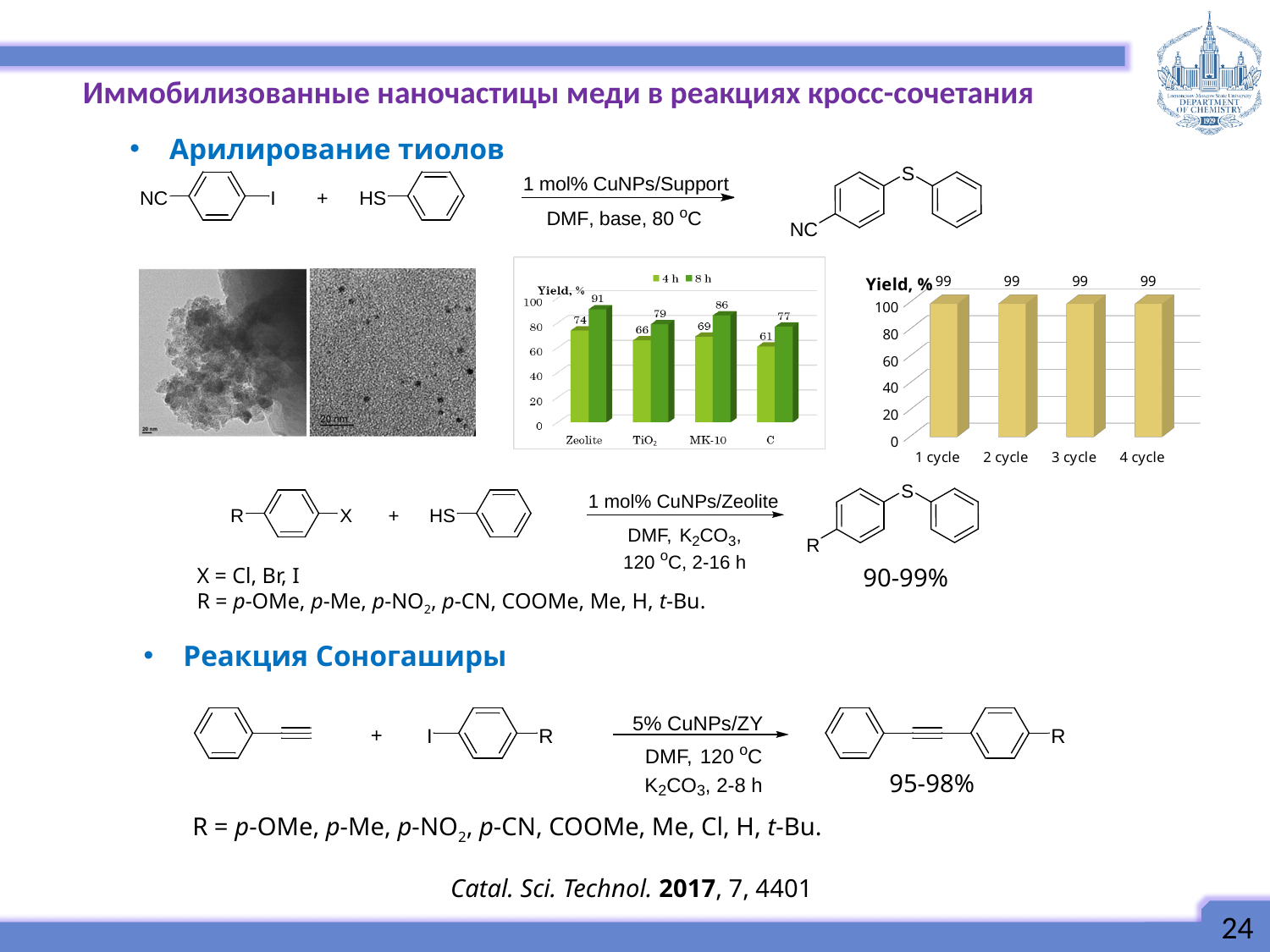
What kind of chart is the right chart (Yield, % by cycle)? Bar chart In the left chart (Yield, % by support), what is the difference between the 8 h and 4 h yields for C? 16 In the left chart (Yield, % by support), is the 4 h yield for MK-10 larger or the 4 h yield for TiO2? MK-10 In the left chart (Yield, % by support), which support has the lowest yield at 4 h? C In the left chart (Yield, % by support), how many series does the legend list? 2 In the right chart (Yield, % by cycle), how many cycles are shown? 4 In the left chart (Yield, % by support), which support has the highest yield at 8 h? Zeolite In the left chart (Yield, % by support), how many supports are shown on the x axis? 4 In the left chart (Yield, % by support), what is the yield for MK-10 at 8 h? 86 In the left chart (Yield, % by support), what is the yield for Zeolite at 8 h? 91 In the left chart (Yield, % by support), what is the yield for TiO2 at 4 h? 66 In the right chart (Yield, % by cycle), what is the yield for 3 cycle? 99